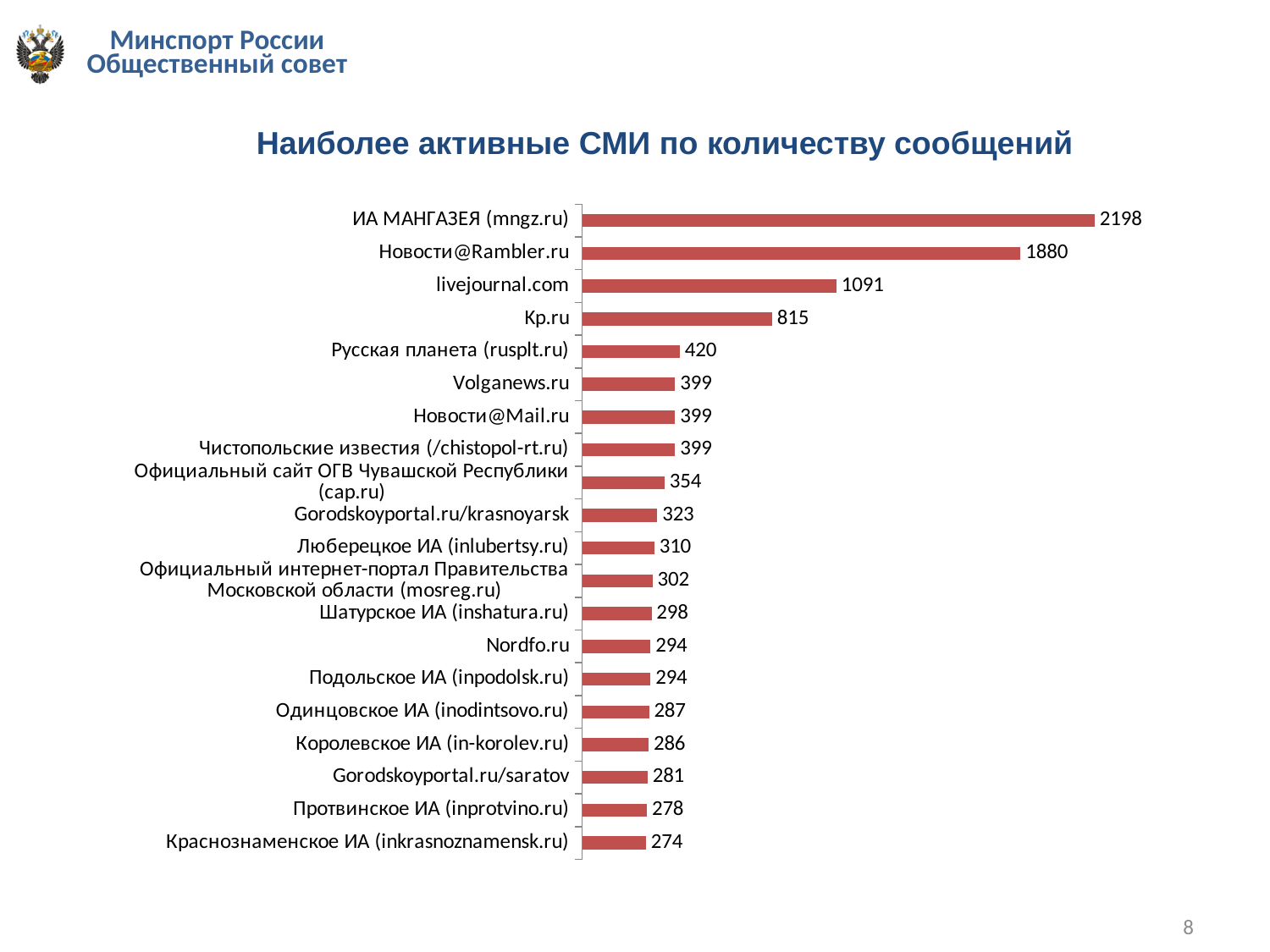
Which source has the lowest number of messages? Краснознаменское ИА (inkrasnoznamensk.ru) What is the value for ИА МАНГАЗЕЯ (mngz.ru)? 2198 What is the value for livejournal.com? 1091 What is the difference between the values for ИА МАНГАЗЕЯ (mngz.ru) and Новости@Rambler.ru? 318 What is the difference between the values for Русская планета (rusplt.ru) and Volganews.ru? 21 How many sources are shown in the chart? 20 What type of chart is shown on the slide? Bar chart What is the title of the chart? Наиболее активные СМИ по количеству сообщений What is the value for Kp.ru? 815 What is the value for Gorodskoyportal.ru/saratov? 281 Which source has the highest number of messages? ИА МАНГАЗЕЯ (mngz.ru) Which has a larger value, livejournal.com or Kp.ru? livejournal.com